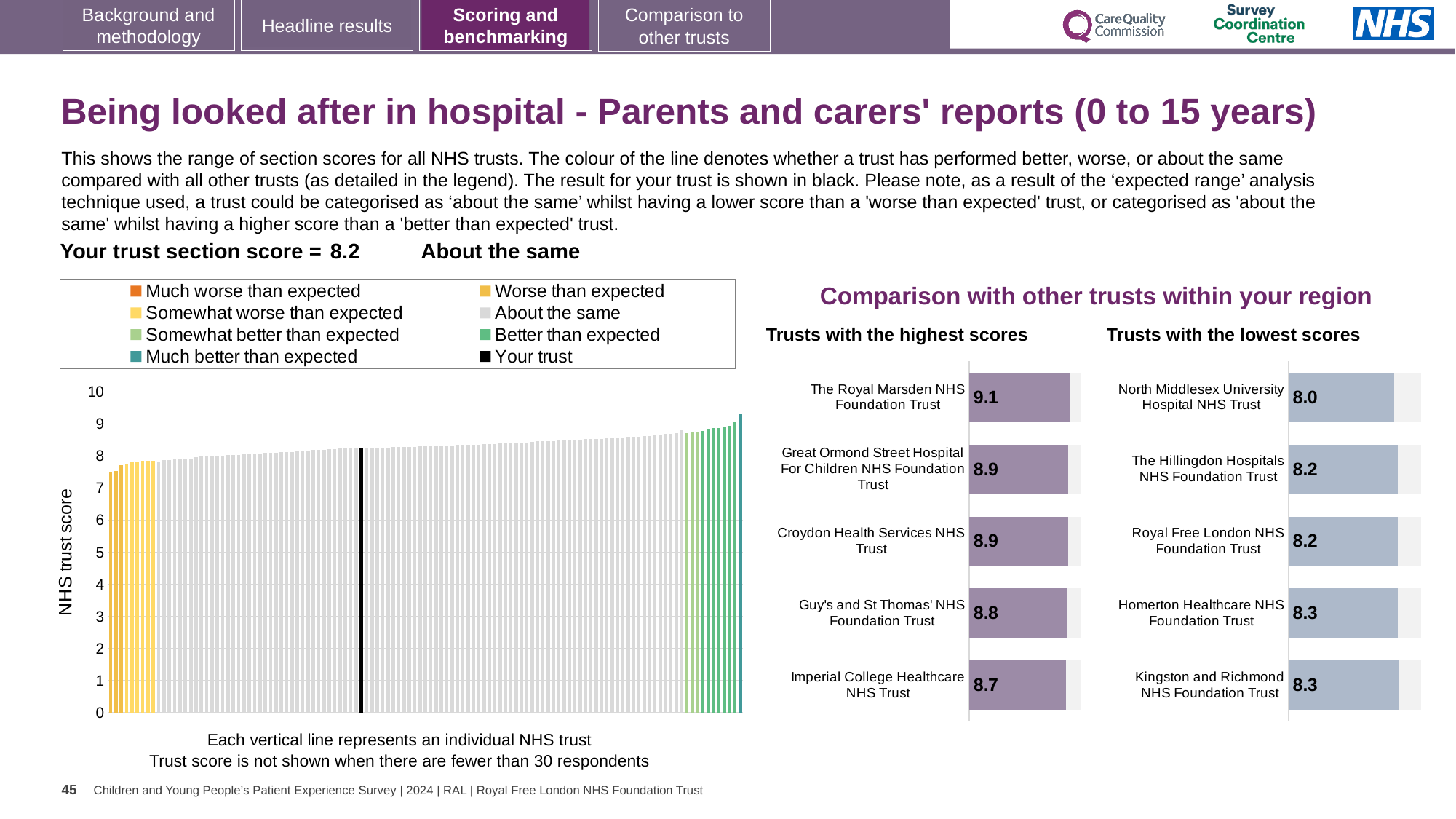
In the 'Trusts with the highest scores' chart, what is the difference between the scores of The Royal Marsden NHS Foundation Trust and Imperial College Healthcare NHS Trust? 0.4 In the main chart on the left showing all NHS trusts, how many entries does the legend list? 8 In the 'Trusts with the highest scores' chart, what is the score for The Royal Marsden NHS Foundation Trust? 9.1 In the main chart on the left showing all NHS trusts, is the value of the tallest bar greater or less than 9? greater In the 'Trusts with the lowest scores' chart, what is the score for North Middlesex University Hospital NHS Trust? 8.0 In the 'Trusts with the lowest scores' chart, which has the larger score: Homerton Healthcare NHS Foundation Trust or North Middlesex University Hospital NHS Trust? Homerton Healthcare NHS Foundation Trust In the 'Trusts with the lowest scores' chart, what is the difference between the scores of Kingston and Richmond NHS Foundation Trust and North Middlesex University Hospital NHS Trust? 0.3 In the 'Trusts with the highest scores' chart, which trust has the highest score? The Royal Marsden NHS Foundation Trust In the 'Trusts with the highest scores' chart, how many trusts are shown? 5 In the 'Trusts with the highest scores' chart, what is the score for Imperial College Healthcare NHS Trust? 8.7 In the 'Trusts with the lowest scores' chart, which trust has the lowest score? North Middlesex University Hospital NHS Trust In the main chart on the left showing all NHS trusts, what kind of chart is it? Bar chart